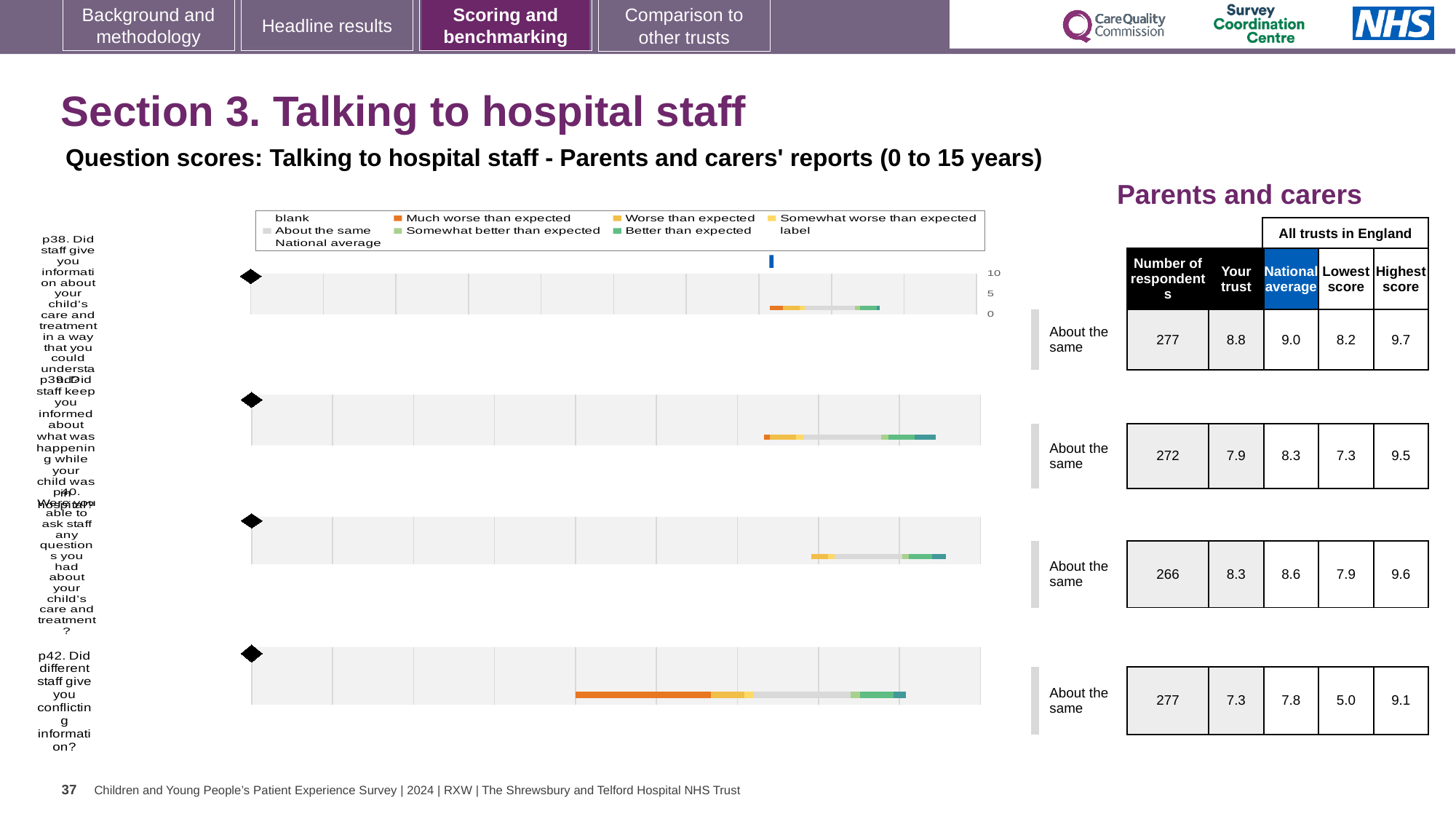
In the table next to the charts, what is the National average for p39 (Did staff keep you informed about what was happening while your child was in hospital)? 8.3 Which question has the highest 'Your trust' score in the table next to the charts? p38 For p38, what is the difference between the Highest score and the Lowest score in the table? 1.5 In the table next to the charts, what is the 'Your trust' score for p38 (Did staff give you information about your child's care and treatment in a way that you could understand)? 8.8 What kind of charts are shown on the left of the slide for the four questions? bar charts In the table next to the charts, what is the Lowest score for p42 (Did different staff give you conflicting information)? 5.0 Which question has the lowest 'Your trust' score in the table next to the charts? p42 For p42, is the 'Your trust' score or the National average larger? National average In the table next to the charts, how many respondents are listed for p40 (Were you able to ask staff any questions you had about your child's care and treatment)? 266 What benchmark category is shown beside each of the four charts? About the same How many questions (p38, p39, p40, p42) have a benchmarking bar chart on the slide? 4 In the chart legend, which colour represents 'Much worse than expected'? orange